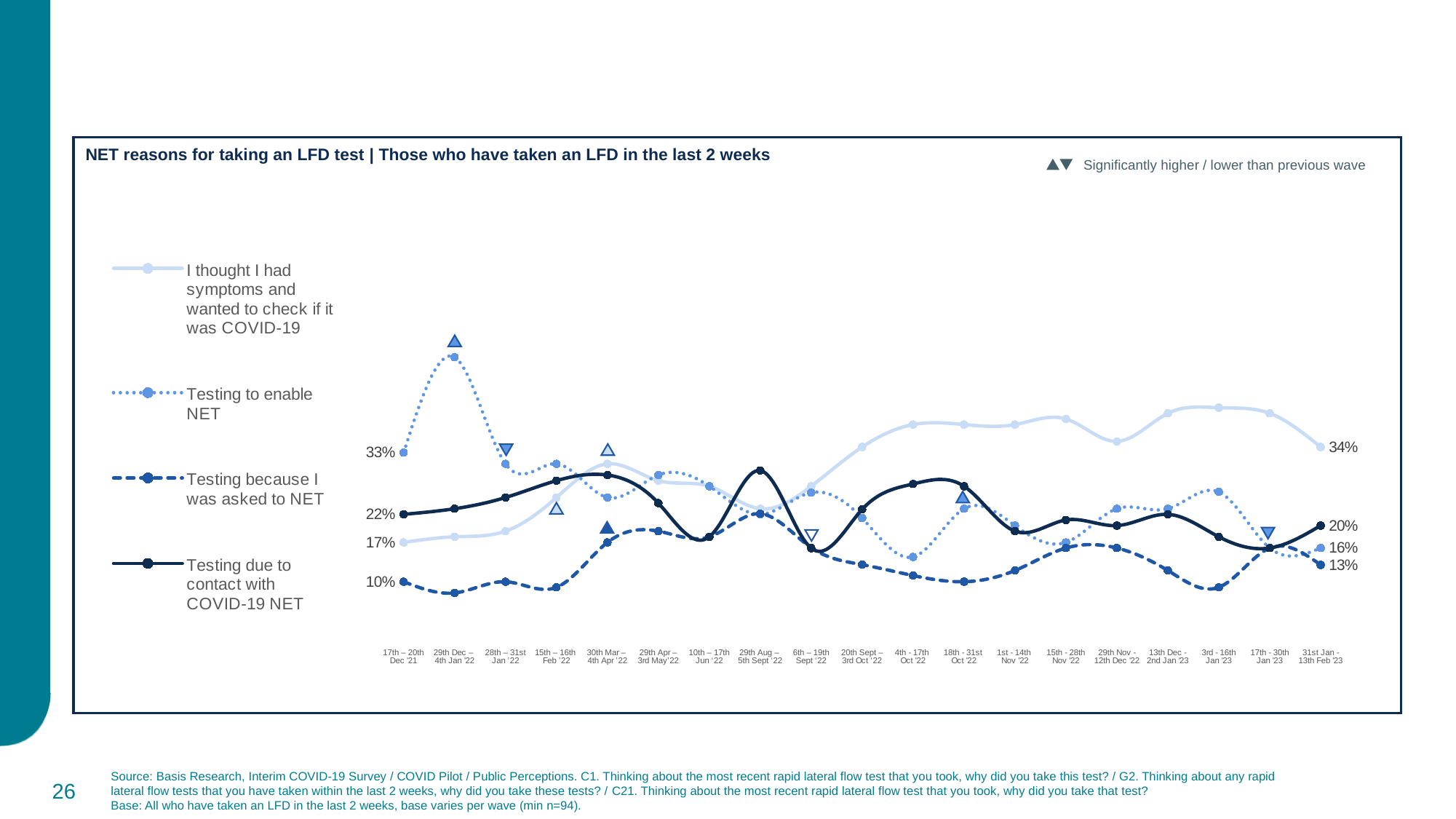
Which series has the highest value in the final wave (31st Jan - 13th Feb '23)? I thought I had symptoms and wanted to check if it was COVID-19 What type of chart is shown on the slide? Line chart How many series does the legend list? 4 What is the value for 'Testing because I was asked to NET' in the final wave (31st Jan - 13th Feb '23)? 13% What is the value for 'Testing due to contact with COVID-19 NET' in the first wave (17th – 20th Dec '21)? 22% Which series has the lowest value in the first wave (17th – 20th Dec '21)? Testing because I was asked to NET How many waves (x-axis points) are plotted on the chart? 19 In the final wave, which is larger: 'Testing due to contact with COVID-19 NET' or 'Testing to enable NET'? Testing due to contact with COVID-19 NET What is the value for 'I thought I had symptoms and wanted to check if it was COVID-19' in the final wave (31st Jan - 13th Feb '23)? 34% By how many percentage points did 'I thought I had symptoms and wanted to check if it was COVID-19' change from the first wave (17%) to the final wave (34%)? 17 percentage points What is the value for 'Testing to enable NET' in the first wave (17th – 20th Dec '21)? 33% Overall from the first wave to the last wave, did 'Testing to enable NET' rise or fall? Fall